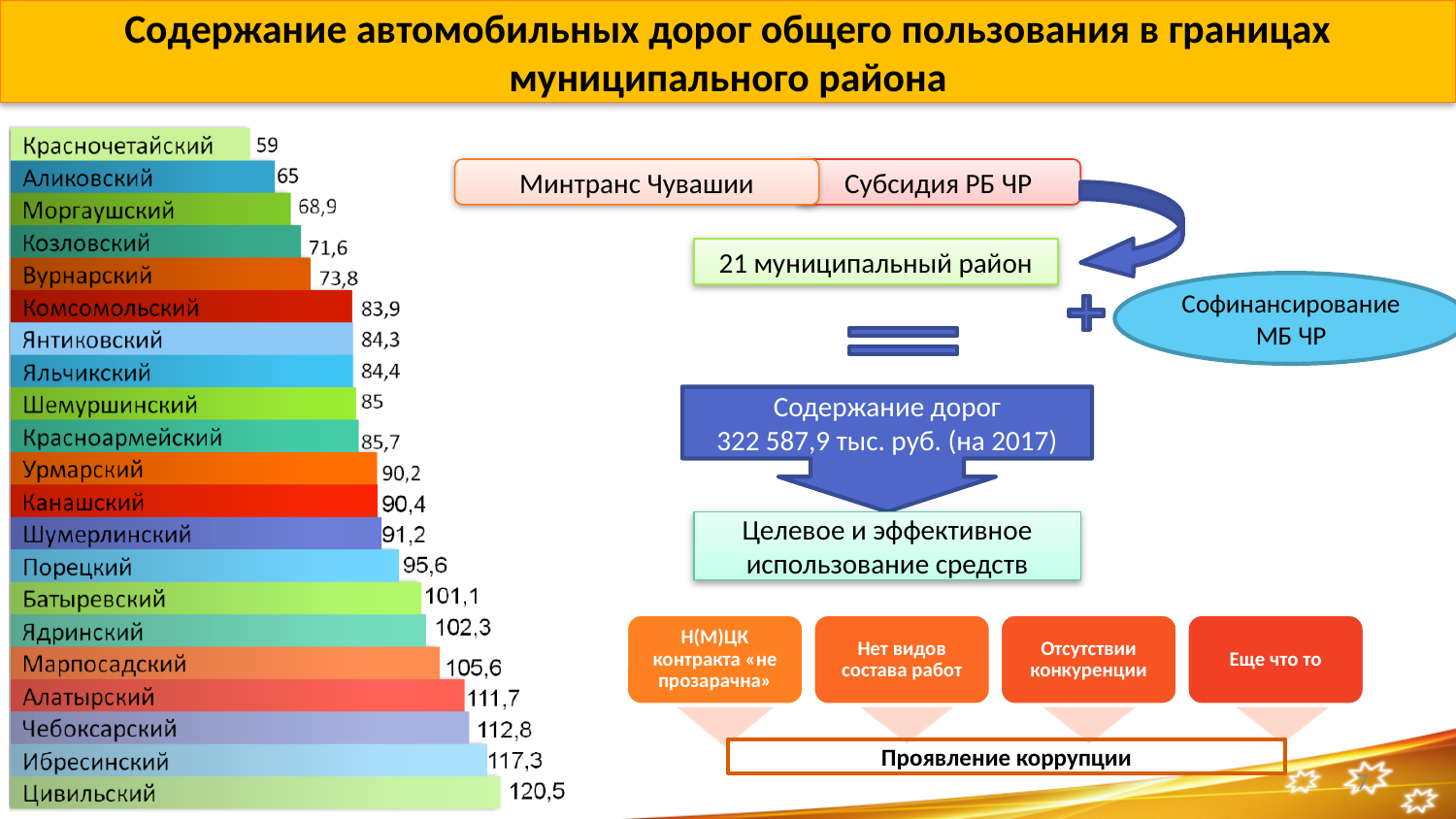
Which has a larger value, Батыревский or Порецкий? Батыревский What is the value for Марпосадский in the bar chart? 105,6 What is the value for Шумерлинский in the bar chart? 91,2 Which district has the highest value in the bar chart? Цивильский Which has a larger value, Аликовский or Вурнарский? Вурнарский What is the value for Цивильский in the bar chart? 120,5 How many districts are shown in the bar chart? 21 What kind of chart is shown on the left of the slide? Bar chart What is the difference between the values for Цивильский and Красночетайский? 61,5 Which district has the lowest value in the bar chart? Красночетайский What is the difference between the values for Чебоксарский and Алатырский? 1,1 What is the value for Красночетайский in the bar chart? 59